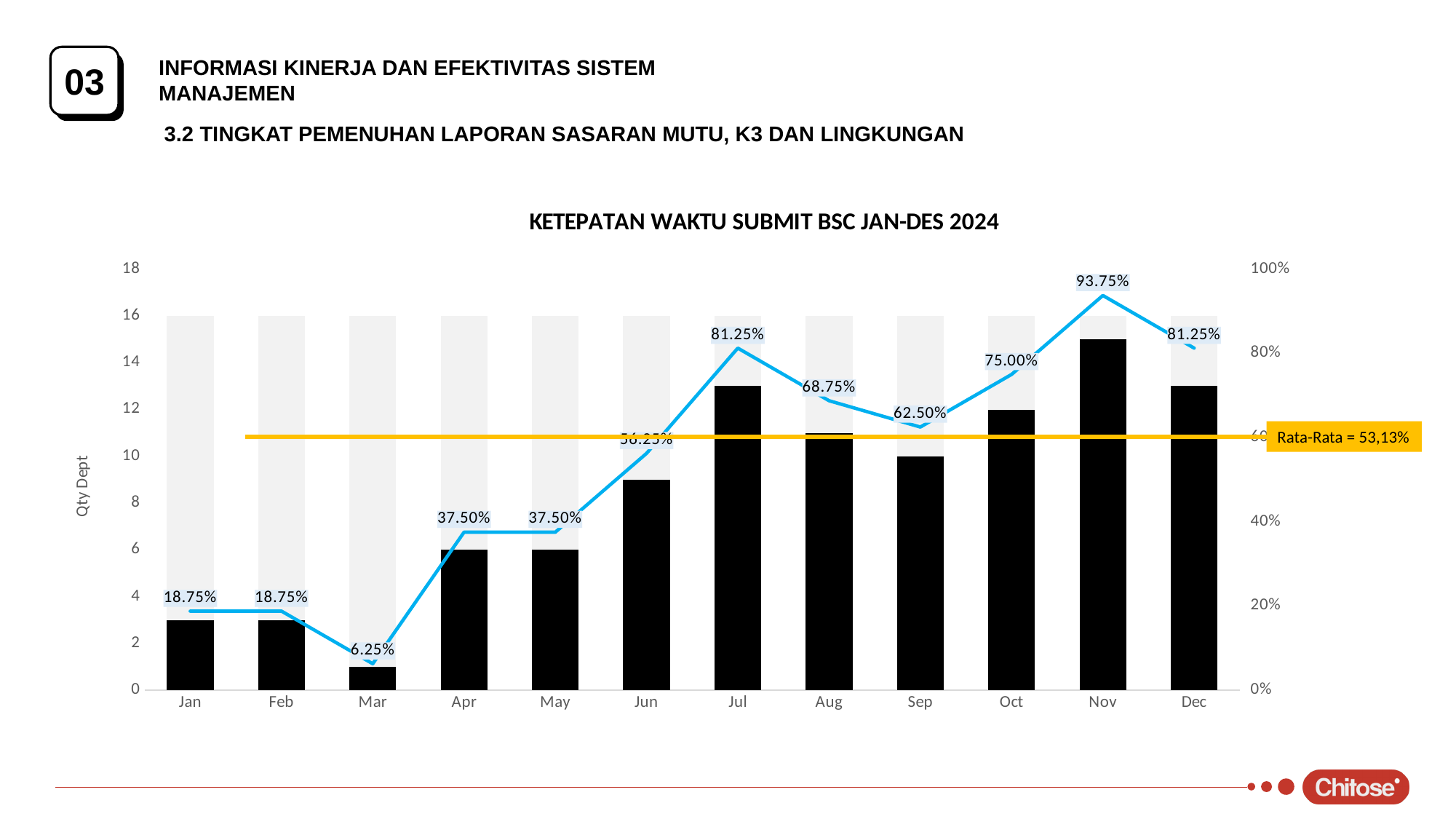
What is the Rata-Rata value shown on the chart? 53,13% What is the percentage value shown for Nov in the KETEPATAN WAKTU SUBMIT BSC JAN-DES 2024 chart? 93.75% What is the percentage value shown for Mar? 6.25% Is the Qty Dept bar for Mar greater or less than 2? less What is the percentage value shown for Jun? 56.25% Which month has the larger percentage, Jul or Aug? Jul What kind of chart is shown on the slide? Combination bar and line chart What is the difference between the percentage for Nov and the percentage for Mar? 87.50% How many months are shown on the x axis of the chart? 12 Is the Qty Dept bar for Nov greater or less than 14? greater Which month has the highest percentage on the line? Nov Which month has the lowest percentage on the line? Mar